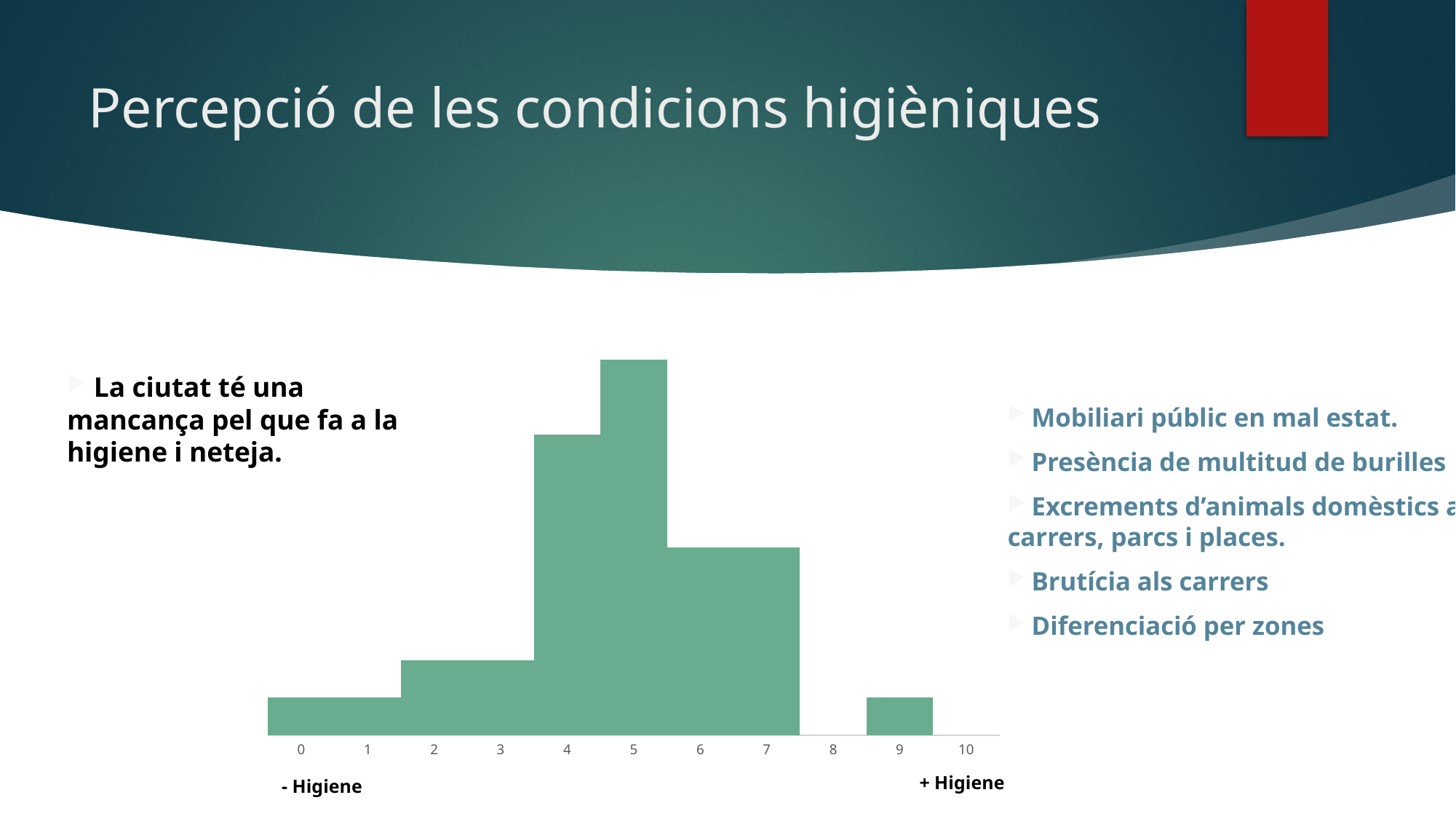
Do the bar heights rise or fall from category 0 to category 5? rise Which is larger, the bar for category 5 or the bar for category 3? 5 Which is larger, the bar for category 2 or the bar for category 0? 2 What label appears below the right end of the x axis? + Higiene Do the bar heights rise or fall from category 5 to category 7? fall Which category on the x axis has the tallest bar? 5 Which categories on the x axis have no visible bar at all? 8 and 10 Which is larger, the bar for category 9 or the bar for category 7? 7 What label appears below the left end of the x axis? - Higiene What kind of chart is shown on the slide? bar chart How many categories are labelled along the x axis of the chart? 11